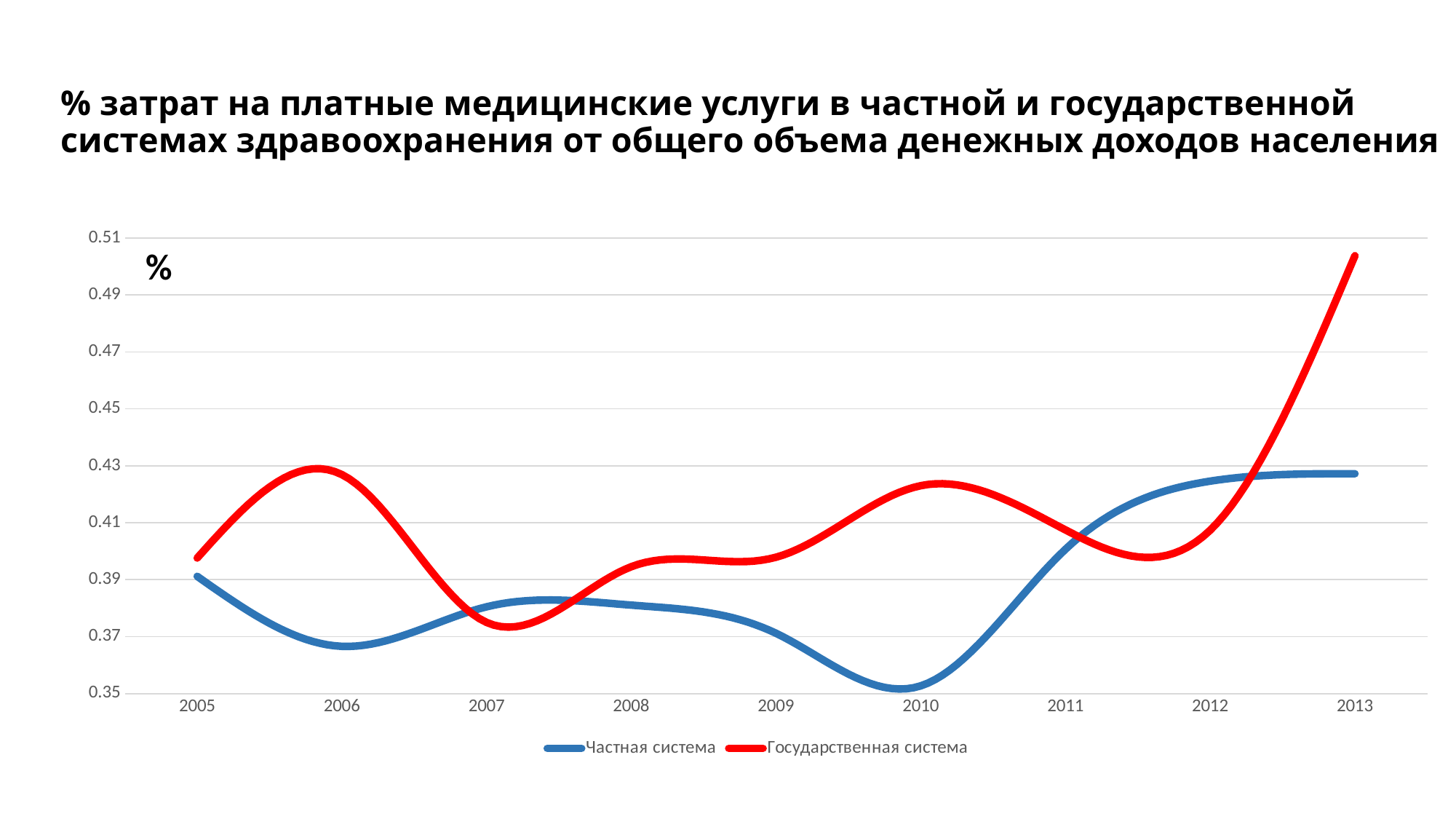
How many series does the legend list? 2 Is the value for Государственная система in 2013 greater or less than 0.49? greater In which year does Государственная система reach its highest value? 2013 Is the value for Государственная система in 2007 greater or less than 0.39? less Is the value for Частная система in 2010 greater or less than 0.37? less In 2013, which series has the higher value, Частная система or Государственная система? Государственная система In 2010, which series has the higher value, Частная система or Государственная система? Государственная система What are the two series named in the legend? Частная система, Государственная система What kind of chart is shown on the slide? line chart Which series is drawn in red? Государственная система How many years are shown on the x axis? 9